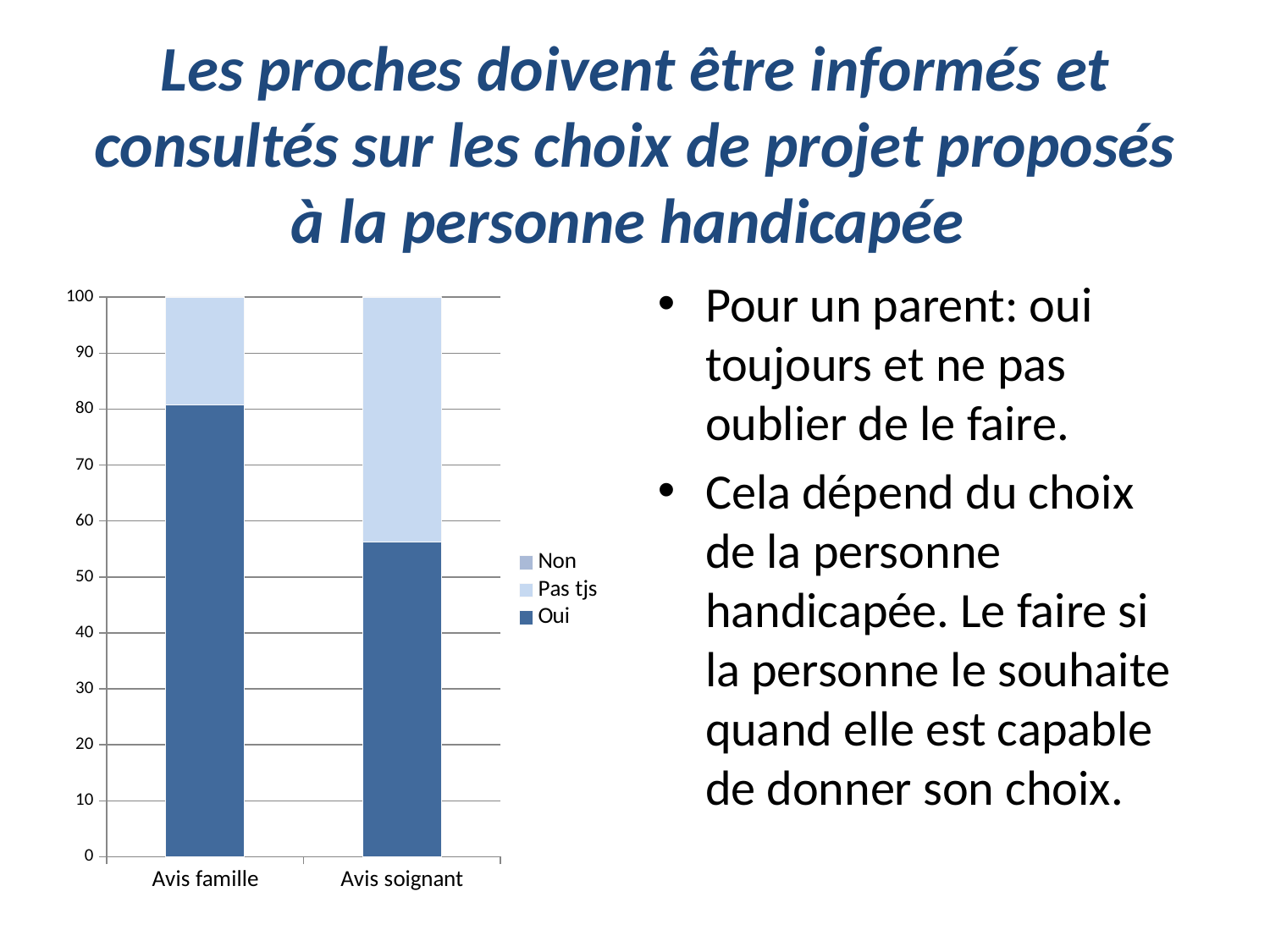
Which series is drawn in the darkest blue in the chart? Oui Which category has the larger 'Pas tjs' value, Avis famille or Avis soignant? Avis soignant Is the 'Oui' value for Avis soignant greater or less than 50? greater Is the 'Oui' value for Avis soignant greater or less than 60? less What is the total height of the stacked bar for Avis famille? 100 Is the 'Oui' value for Avis famille greater or less than 70? greater Which series are listed in the chart legend? Non, Pas tjs, Oui How many series does the chart legend list? 3 Which category has the larger 'Oui' value, Avis famille or Avis soignant? Avis famille What kind of chart is shown on the slide? stacked bar chart Does the 'Oui' value rise or fall from Avis famille to Avis soignant? fall How many categories are shown on the x axis of the chart? 2